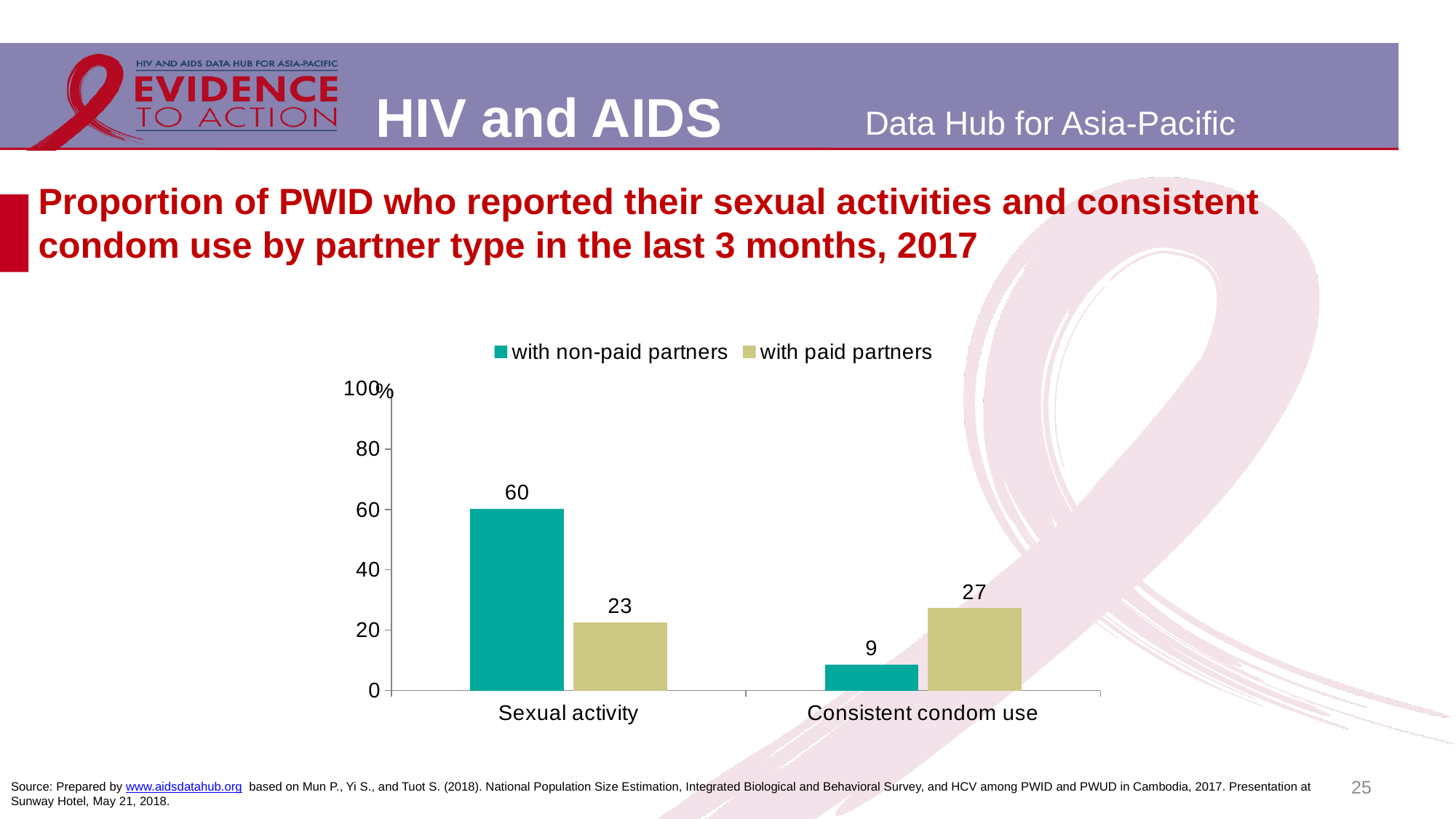
What is the difference between the 'with paid partners' and 'with non-paid partners' values for Consistent condom use? 18 For Consistent condom use, which is larger: the value with non-paid partners or with paid partners? with paid partners Which bar has the lowest value on the chart? Consistent condom use, with non-paid partners What kind of chart is shown on the slide? Bar chart What is the value for 'with non-paid partners' in the Consistent condom use category? 9 What is the value for 'with paid partners' in the Sexual activity category? 23 How many categories are shown on the x axis? 2 What is the value for 'with non-paid partners' in the Sexual activity category? 60 What is the difference between the 'with non-paid partners' and 'with paid partners' values for Sexual activity? 37 What is the value for 'with paid partners' in the Consistent condom use category? 27 How many series does the legend list? 2 Which bar has the highest value on the chart? Sexual activity, with non-paid partners